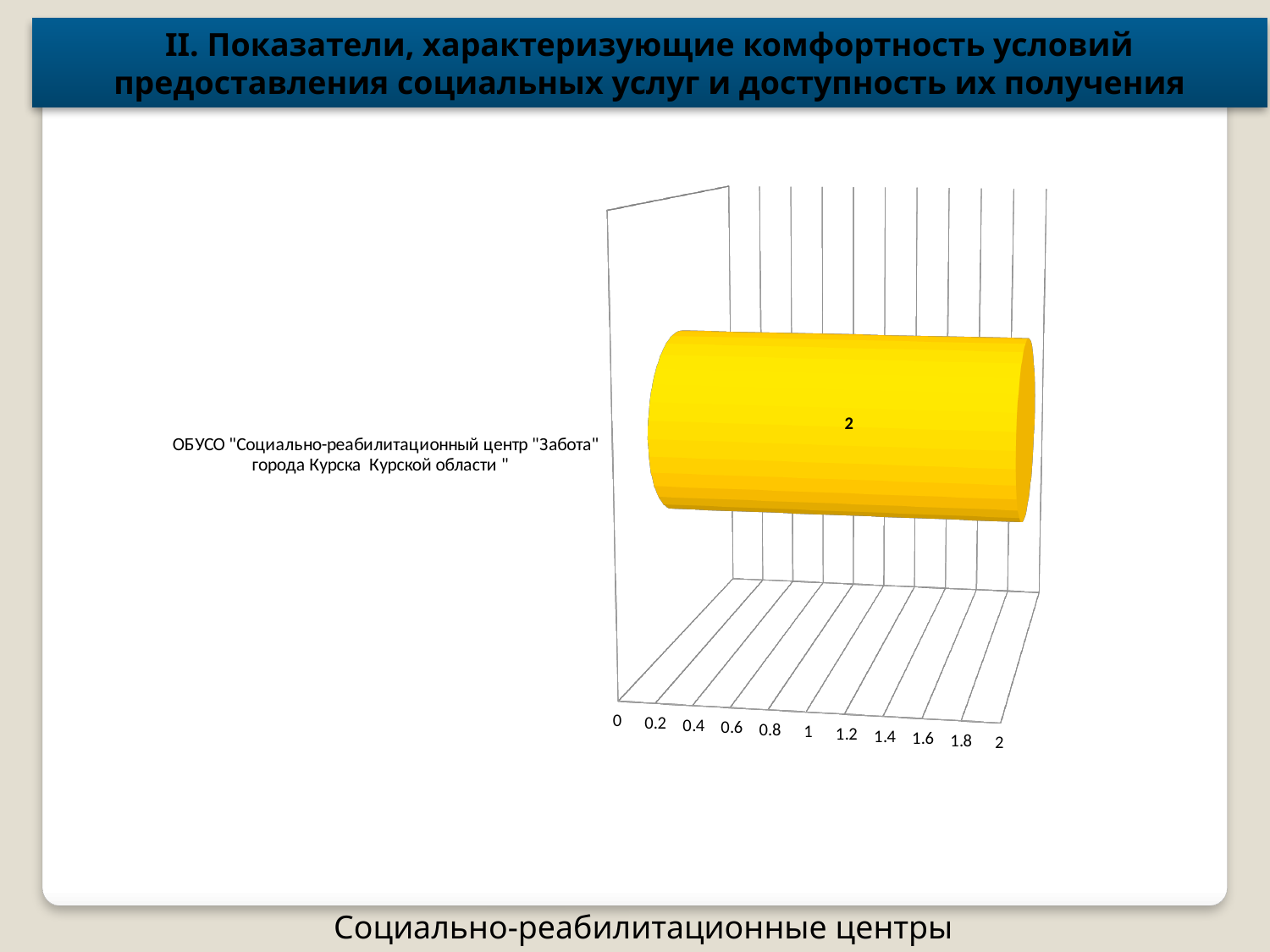
What colour is the bar in the chart? yellow What is the value shown for ОБУСО "Социально-реабилитационный центр "Забота" города Курска Курской области"? 2 How many categories are plotted in the chart? 1 Are the bars in the chart drawn horizontally or vertically? horizontally What kind of chart is shown on the slide? bar chart Is the value for ОБУСО "Социально-реабилитационный центр "Забота" greater or less than 0.2? greater Is the value for ОБУСО "Социально-реабилитационный центр "Забота" greater or less than 1? greater What is the data label printed on the bar in the chart? 2 What is the highest tick value shown on the value axis of the chart? 2